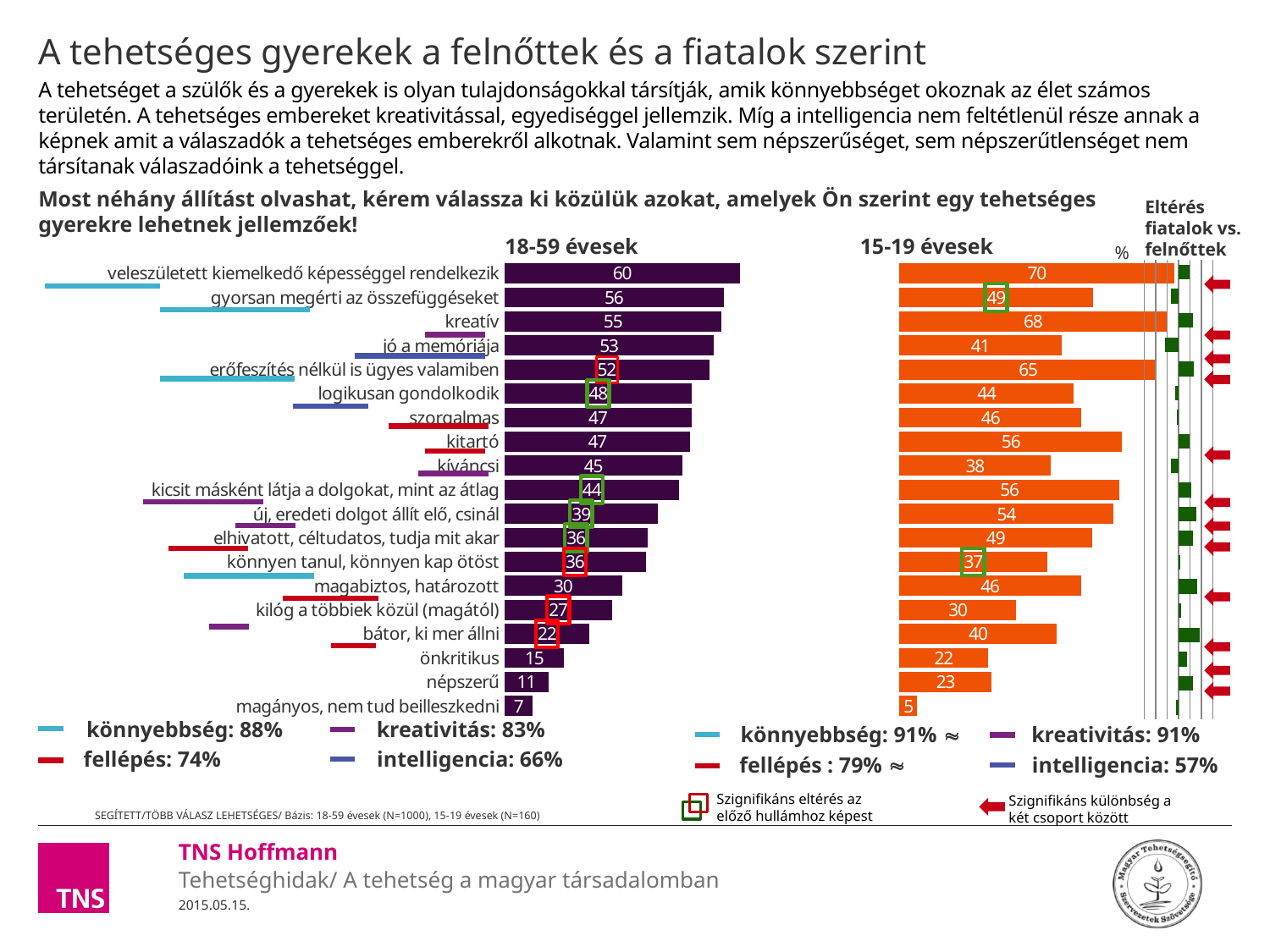
What is the difference between the "15-19 évesek" and "18-59 évesek" values for "kreatív"? 13 In the "18-59 évesek" chart, which category has the highest value? veleszületett kiemelkedő képességgel rendelkezik In the "15-19 évesek" chart, what is the value for "jó a memóriája"? 41 In the "15-19 évesek" chart, which category has the lowest value? magányos, nem tud beilleszkedni In the "18-59 évesek" chart, what is the value for "népszerű"? 11 In the "18-59 évesek" chart, what is the difference between "veleszületett kiemelkedő képességgel rendelkezik" and "magányos, nem tud beilleszkedni"? 53 What kind of chart is the "15-19 évesek" chart? bar chart How many categories are listed in the "18-59 évesek" chart? 19 In the "15-19 évesek" chart, what is the value for "erőfeszítés nélkül is ügyes valamiben"? 65 What colour are the bars in the "15-19 évesek" chart? orange For "bátor, ki mer állni", which group has the larger value: 18-59 évesek or 15-19 évesek? 15-19 évesek In the "18-59 évesek" chart, what is the value for "kreatív"? 55